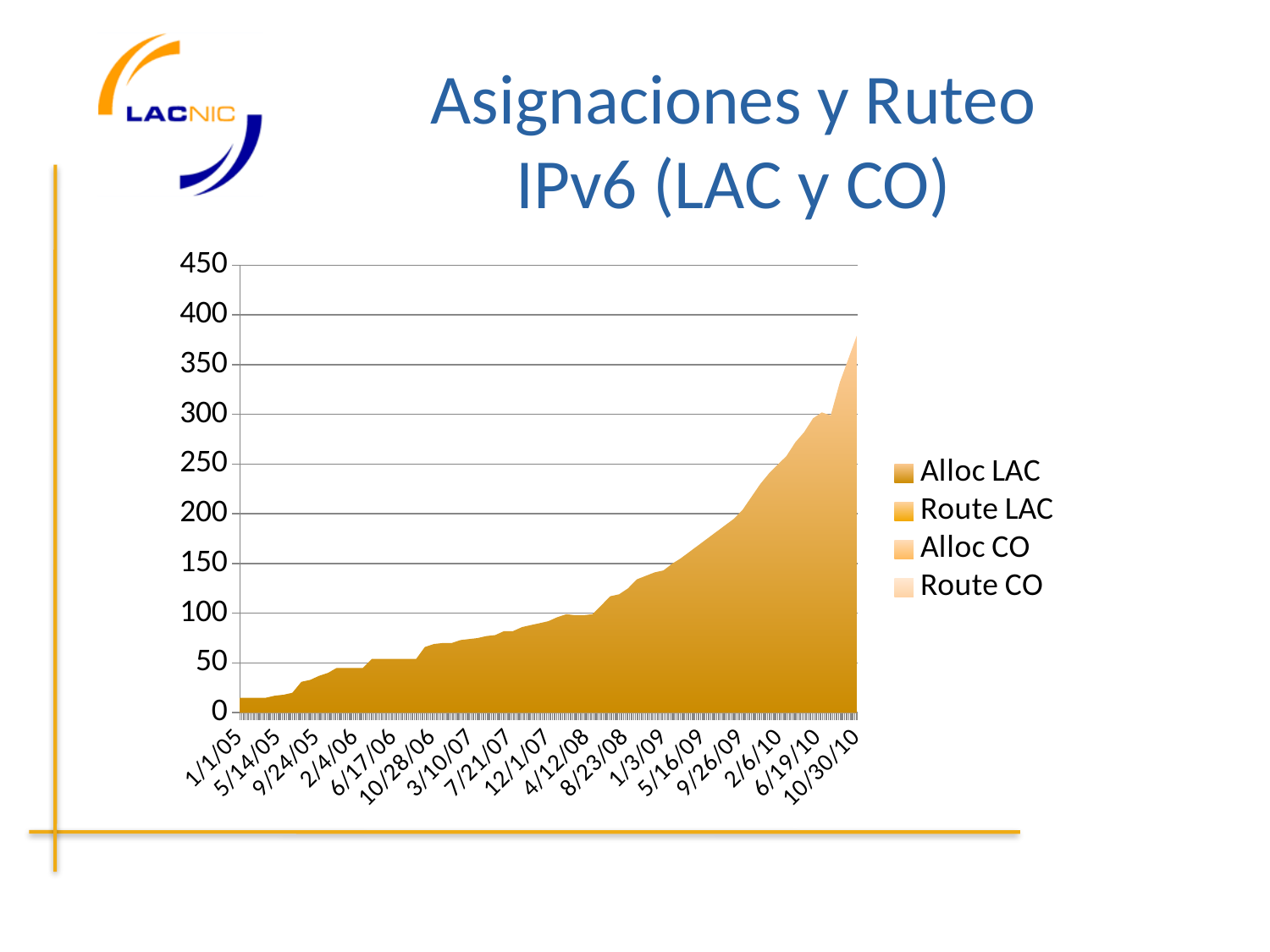
What is the title of the slide containing the chart? Asignaciones y Ruteo IPv6 (LAC y CO) Is the value at 1/1/05 greater or less than 50? less Is the value at 8/23/08 greater or less than 100? greater Is the value at 10/30/10 greater or less than 350? greater At which labelled date does the chart reach its highest value? 10/30/10 What kind of chart is shown on the slide? area chart Which is larger, the value at 1/3/09 or the value at 2/6/10? 2/6/10 Which series are listed in the chart legend? Alloc LAC, Route LAC, Alloc CO, Route CO How many series does the chart legend list? 4 Do the plotted values rise or fall from 1/1/05 to 10/30/10? rise